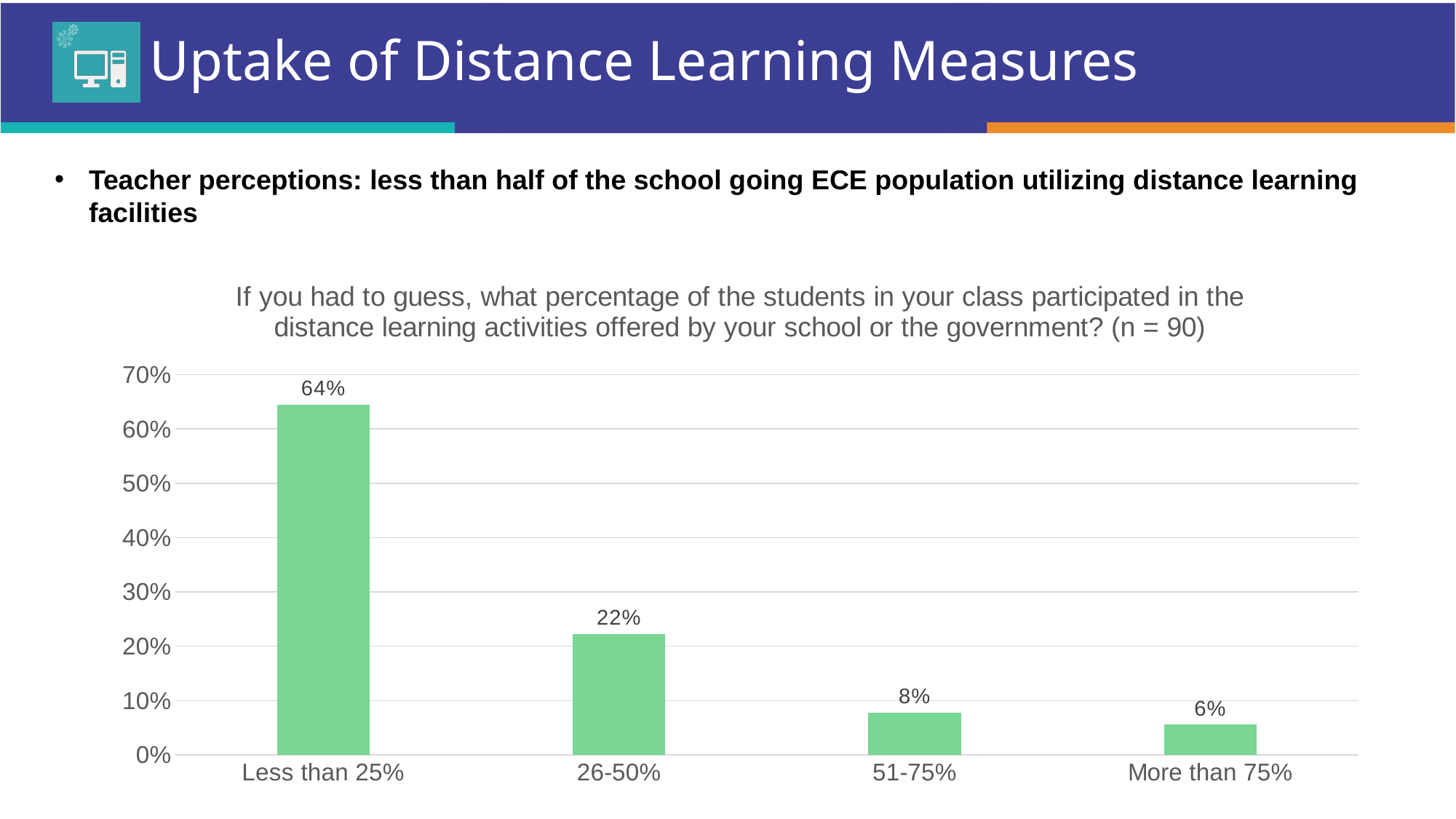
Do the values rise or fall moving from left to right along the x axis? fall Is the value for '26-50%' greater or less than 30%? less What is the value for the '26-50%' category? 22% How many categories are shown on the x axis? 4 Which is larger, the value for '51-75%' or the value for 'More than 75%'? 51-75% Which category has the lowest value? More than 75% What is the value for the '51-75%' category? 8% What kind of chart is shown on the slide? bar chart What is the value for the 'Less than 25%' category? 64% What is the difference between the values for 'Less than 25%' and '26-50%'? 42% What is the value for the 'More than 75%' category? 6% Which category has the highest value? Less than 25%